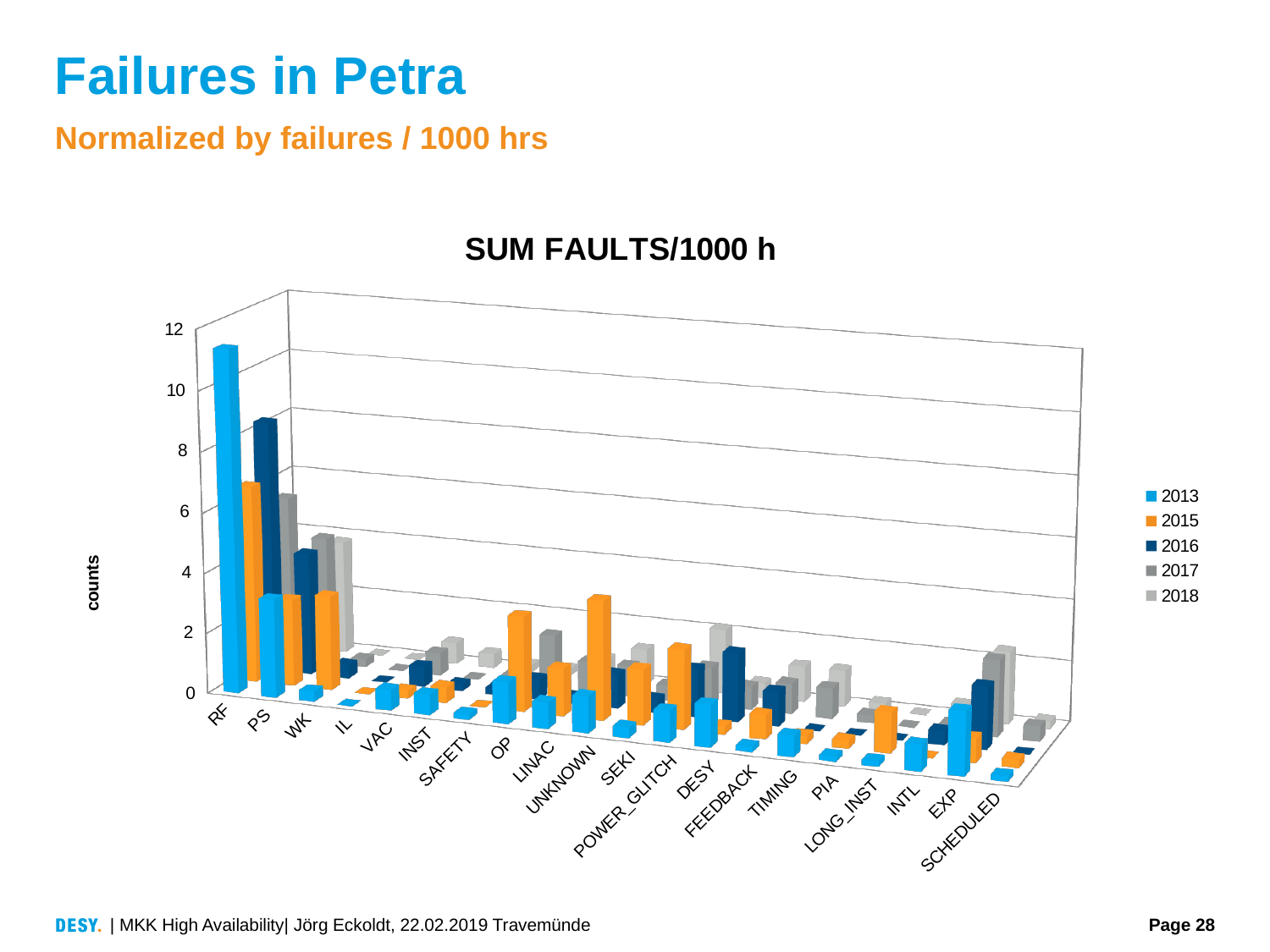
What is the label of the vertical axis? counts Which is larger, the 2015 value for RF or the 2015 value for OP? RF Is the 2013 value for PS greater or less than 4? less How many categories are shown on the x axis of the chart? 20 Is the 2015 value for RF greater or less than 4? greater Which year series is listed first in the legend? 2013 Which category has the highest value for the 2013 series? RF How many series does the legend list? 5 What kind of chart is shown on the slide? bar chart Is the 2013 value for RF greater or less than 10? greater What is the title of the chart? SUM FAULTS/1000 h Which is larger, the 2013 value for RF or the 2013 value for PS? RF